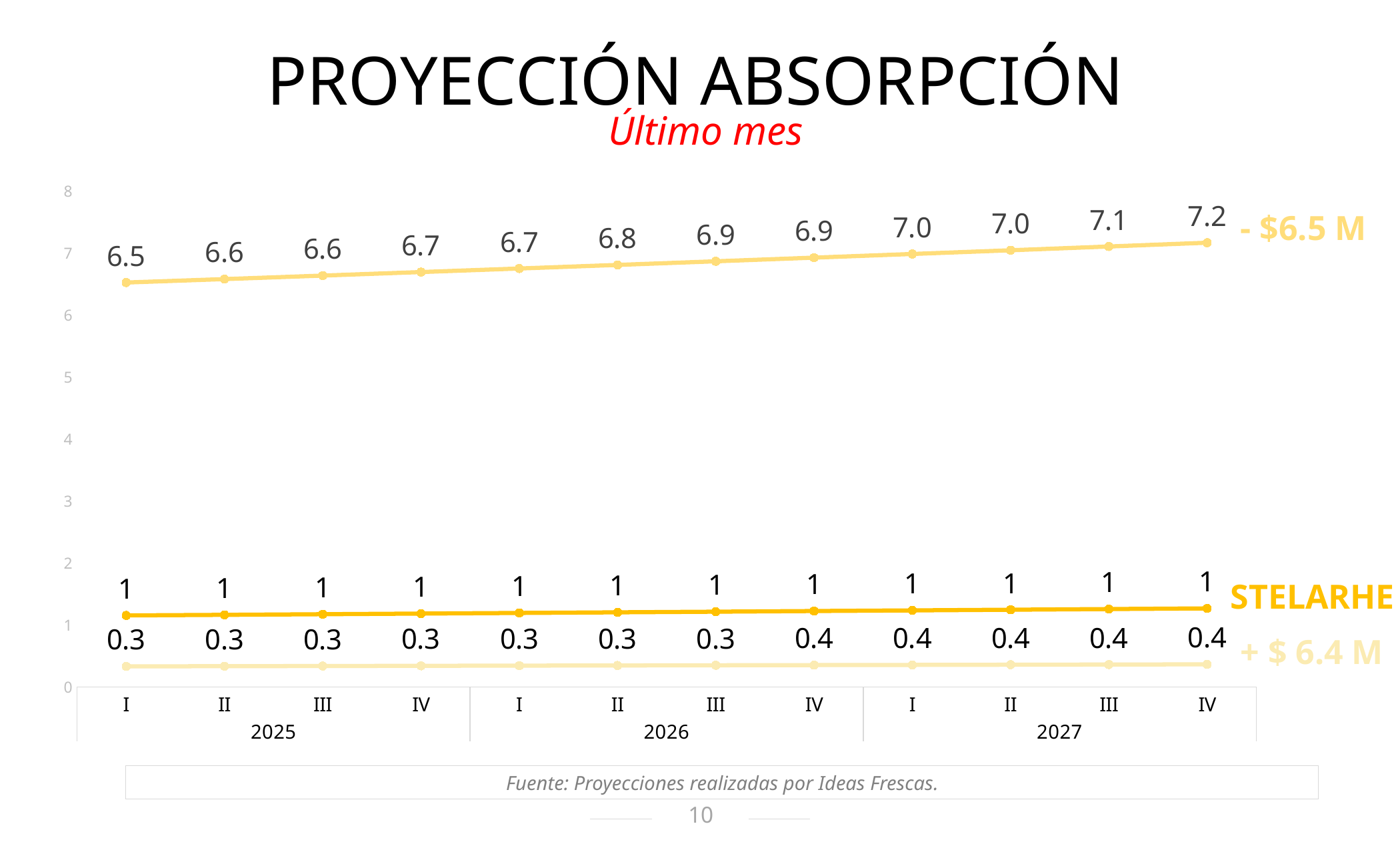
Which series is higher in quarter I of 2026, STELARHE or "+ $ 6.4 M"? STELARHE What is the value of the "+ $ 6.4 M" series in quarter II of 2026? 0.3 In which quarter does the "- $6.5 M" series reach its highest value? IV 2027 Does the "- $6.5 M" series rise or fall from 2025 to 2027? rise What kind of chart is shown on the slide? line chart What is the difference between the "- $6.5 M" series values in quarter IV of 2027 and quarter I of 2025? 0.7 What is the value of the "- $6.5 M" series in quarter IV of 2027? 7.2 How many quarterly data points does each line have? 12 What is the subtitle shown in red under the chart title? Último mes How many series are plotted on the chart? 3 What is the value of the "- $6.5 M" series in quarter I of 2025? 6.5 What is the value of the STELARHE series in quarter III of 2027? 1